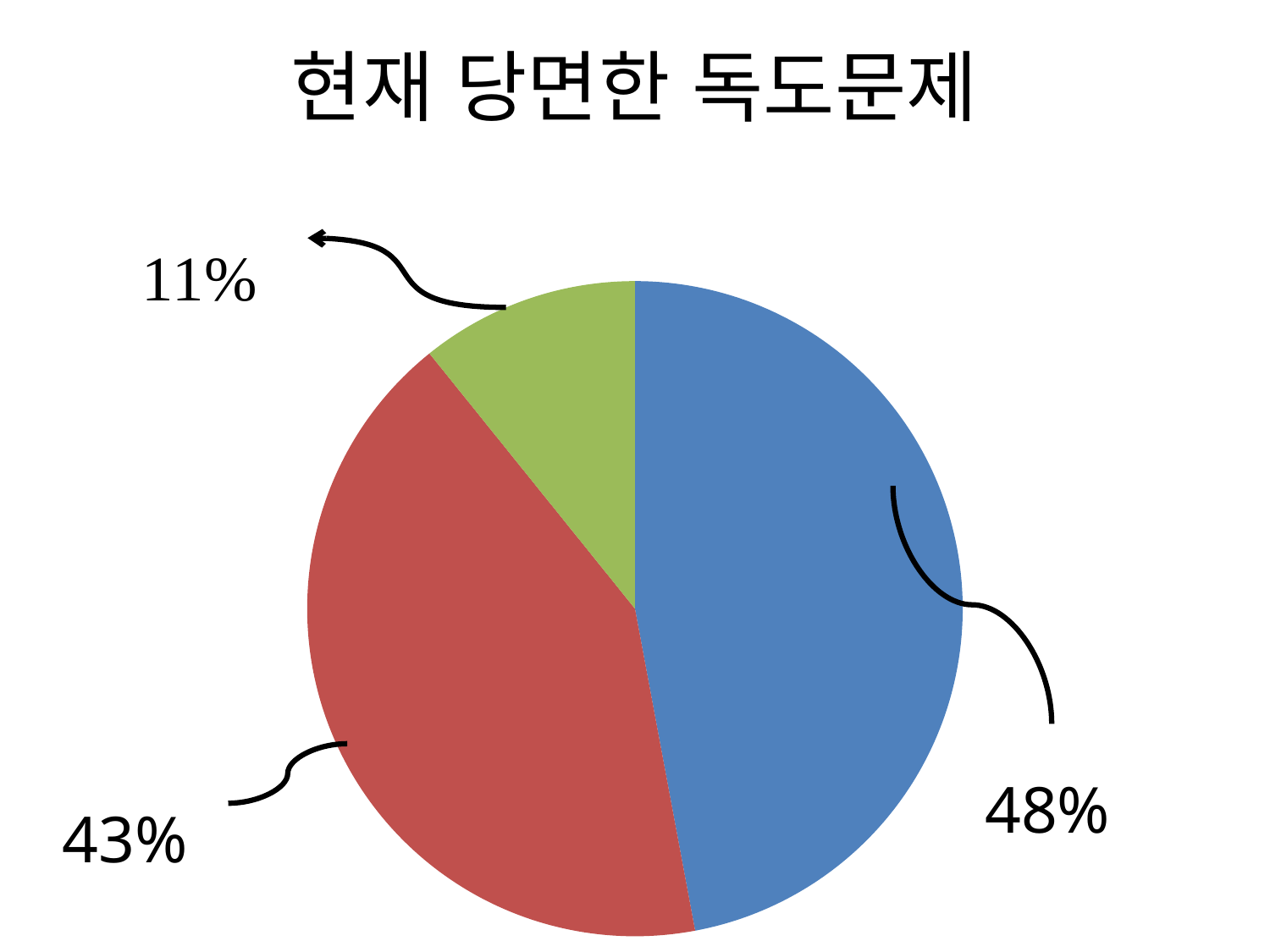
What is the difference between the red slice and the green slice? 32% What colour is the slice labelled 11%? green Which is larger, the red slice or the green slice? the red slice What percentage is shown for the red slice? 43% Which slice is the smallest? the green slice (11%) What percentage is shown for the green slice? 11% Which slice is the largest? the blue slice (48%) What percentage is shown for the blue slice? 48% What is the difference between the blue slice and the red slice? 5% What kind of chart is shown on the slide? pie chart How many slices does the pie chart have? 3 What is the title of the chart? 현재 당면한 독도문제